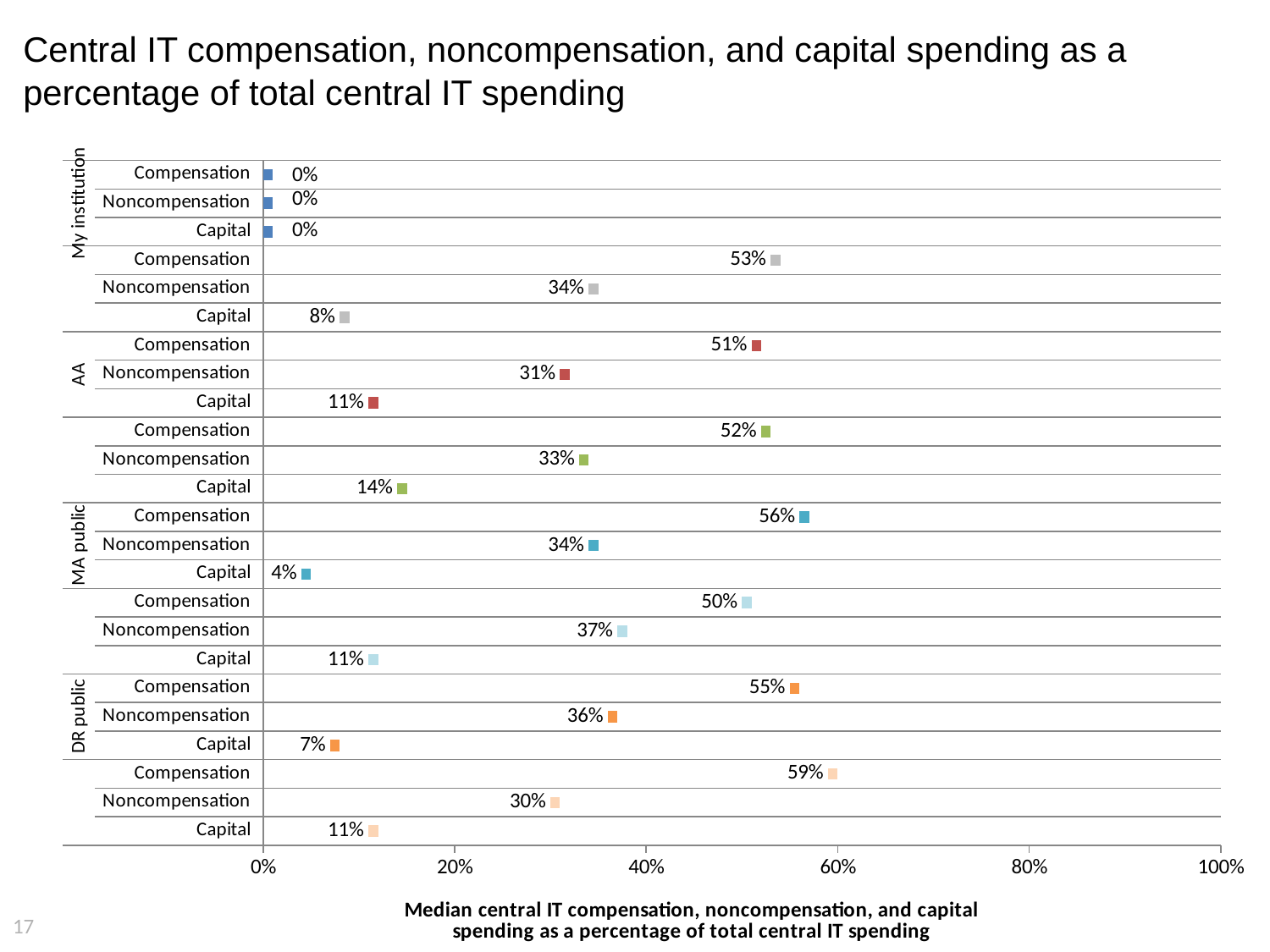
What is the Noncompensation value for AA? 31% What is the difference between the Compensation and Noncompensation values for AA? 20 percentage points Is the Noncompensation value for MA public greater or less than 40%? less What is the Noncompensation value for DR public? 36% Among AA, MA public and DR public, which group has the highest Capital value? AA What is the Capital value for DR public? 7% What is the Compensation value for My institution? 0% What is the x-axis title of the chart? Median central IT compensation, noncompensation, and capital spending as a percentage of total central IT spending What is the Capital value for MA public? 4% What is the Compensation value for MA public? 56% Among AA, MA public and DR public, which group has the lowest Capital value? MA public Which is larger, the Compensation value for MA public or the Compensation value for DR public? MA public